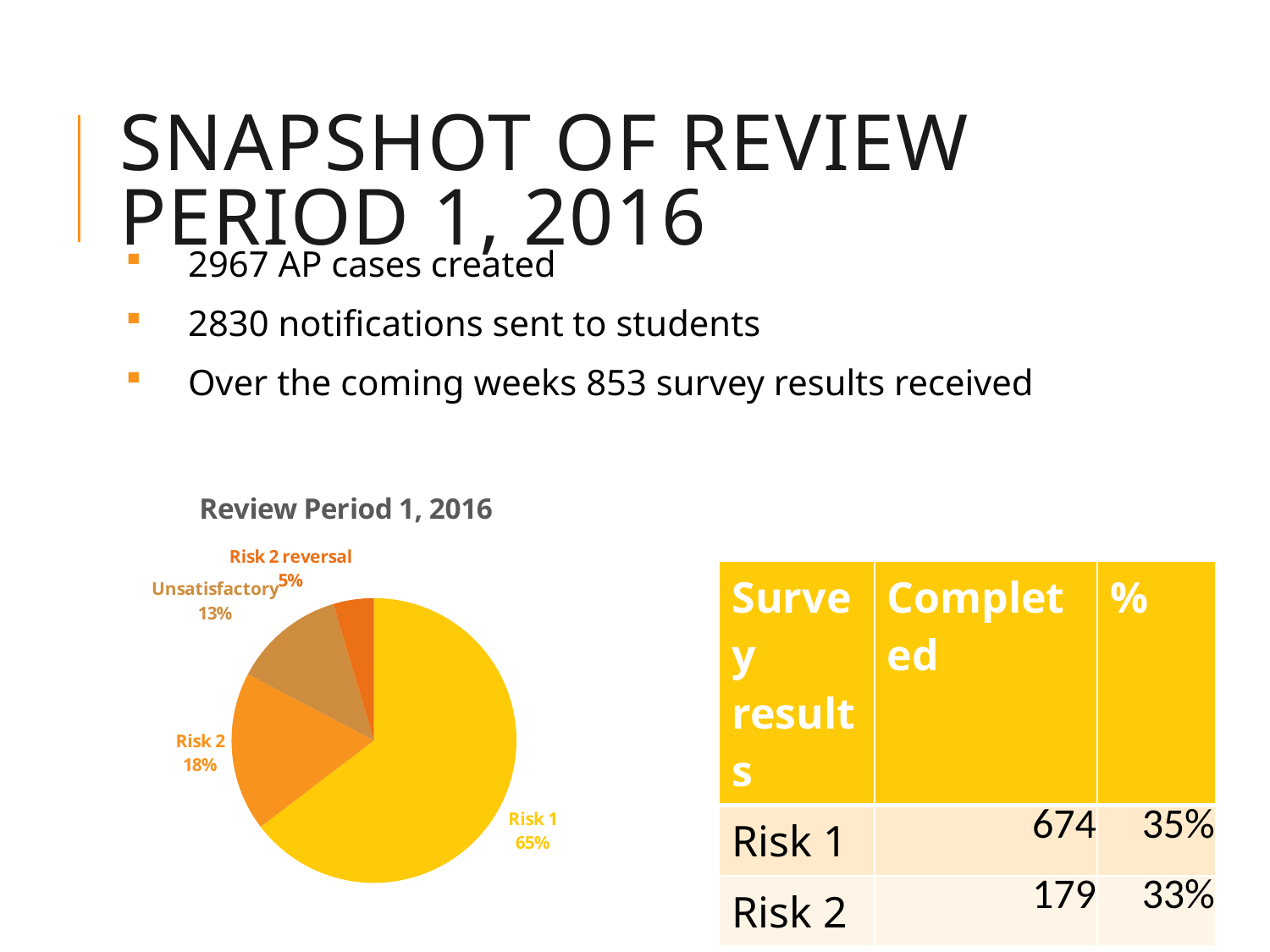
What share of the pie does Risk 1 represent? 65% Which slice is larger, Unsatisfactory or Risk 2? Risk 2 What share of the pie does Unsatisfactory represent? 13% What is the difference in percentage points between the Unsatisfactory and Risk 2 reversal slices? 8 What share of the pie does Risk 2 reversal represent? 5% Which category has the smallest slice of the pie? Risk 2 reversal What is the difference in percentage points between the Risk 1 and Risk 2 slices? 47 Which category has the largest slice of the pie? Risk 1 What type of chart is shown on the slide? Pie chart What is the title of the pie chart? Review Period 1, 2016 How many slices does the pie chart have? 4